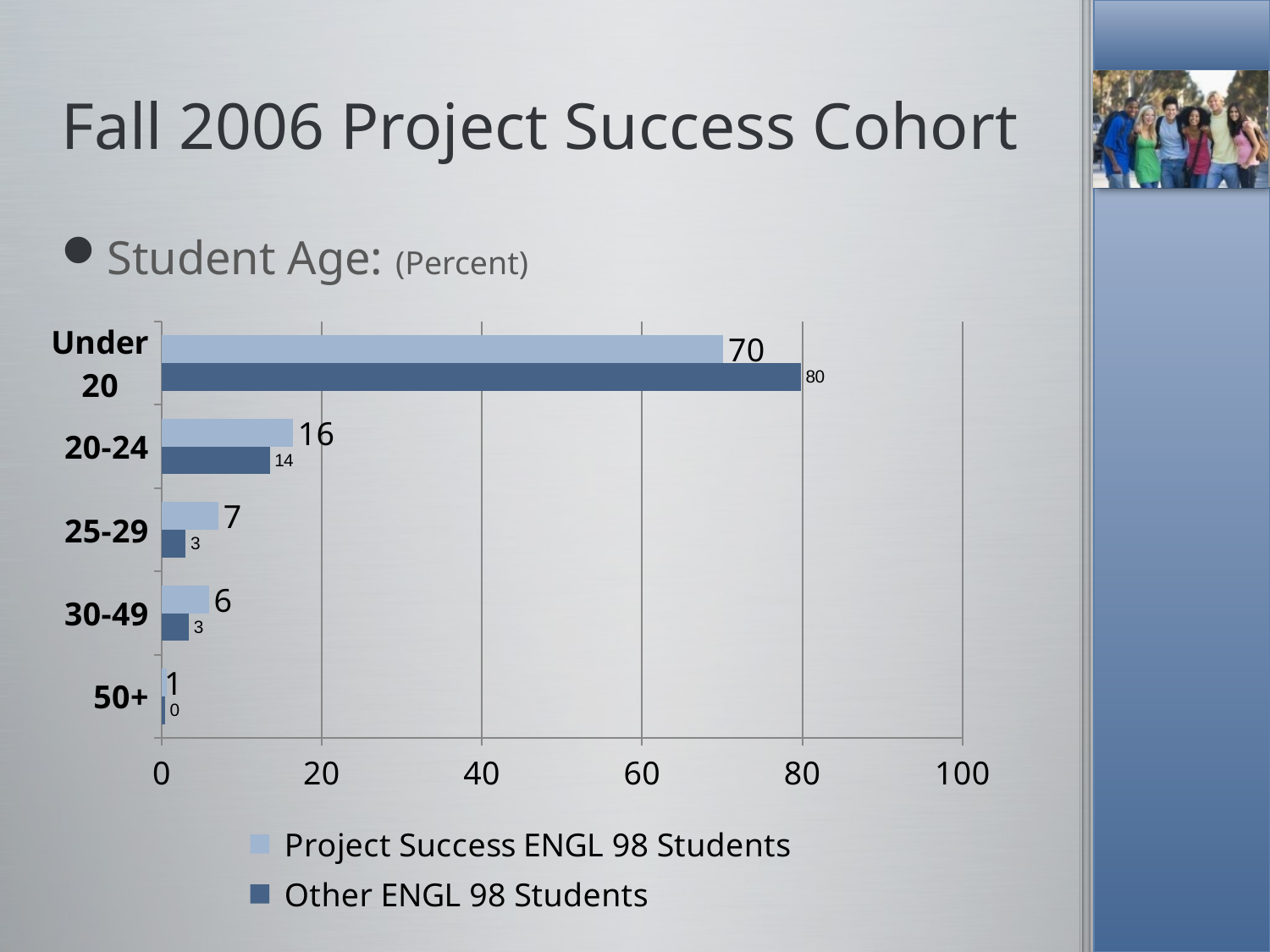
What is the value for Other ENGL 98 Students in the 20-24 age group? 14 Which age group has the highest value for Project Success ENGL 98 Students? Under 20 How many age groups are shown on the chart? 5 What is the value for Project Success ENGL 98 Students in the 25-29 age group? 7 What is the difference between Other ENGL 98 Students and Project Success ENGL 98 Students in the Under 20 age group? 10 How many series does the legend list? 2 In the 20-24 age group, which series has the larger value: Project Success ENGL 98 Students or Other ENGL 98 Students? Project Success ENGL 98 Students What is the value for Project Success ENGL 98 Students in the 30-49 age group? 6 Which age group has the lowest value for Other ENGL 98 Students? 50+ What is the value for Other ENGL 98 Students in the Under 20 age group? 80 What kind of chart is shown on the slide? Bar chart What is the value for Project Success ENGL 98 Students in the Under 20 age group? 70